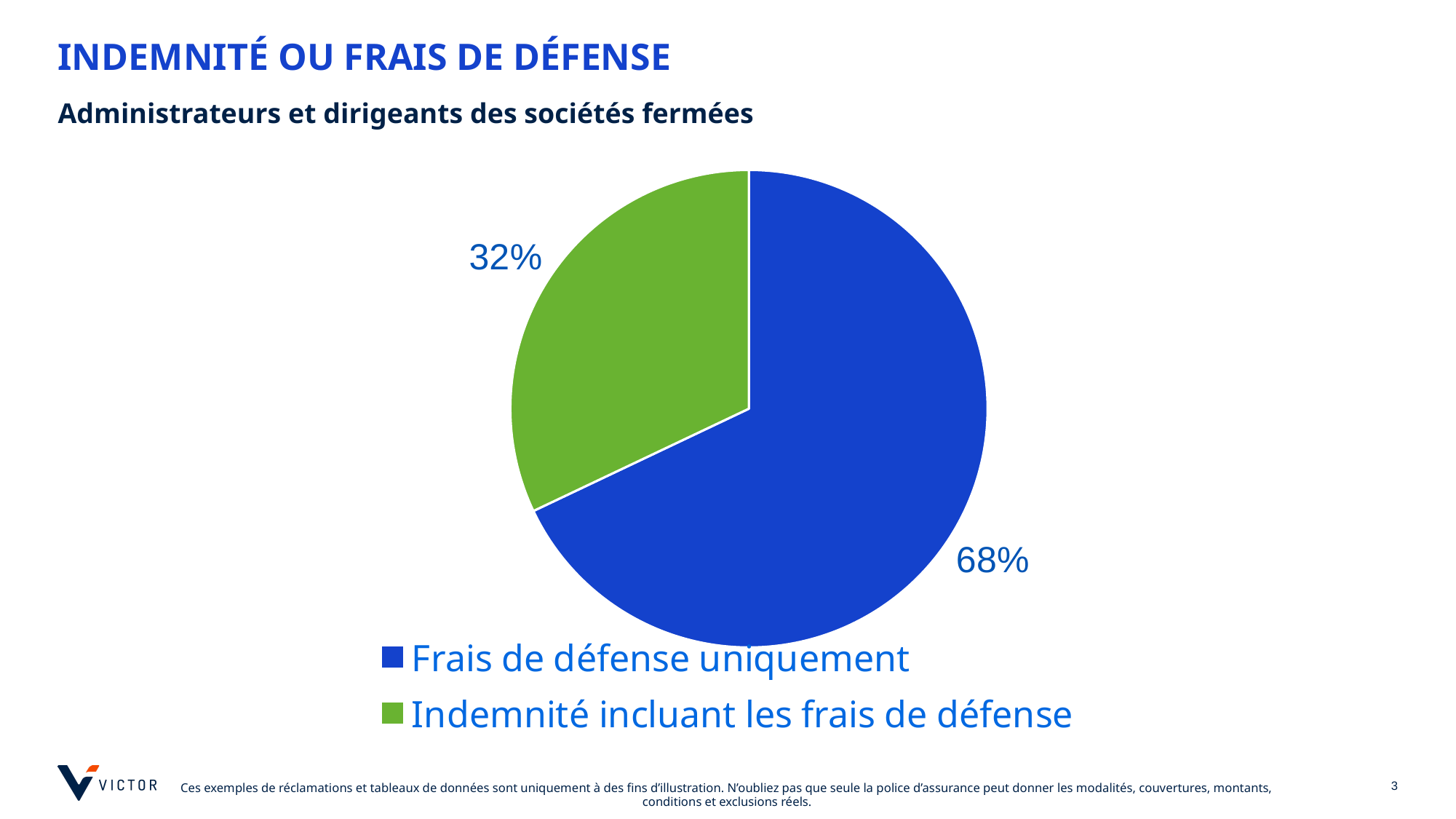
Is the share for "Indemnité incluant les frais de défense" greater or less than 50%? less How many slices does the pie chart have? 2 How many entries does the legend list? 2 What is the difference in percentage points between the "Frais de défense uniquement" slice and the "Indemnité incluant les frais de défense" slice? 36 What colour is the slice for "Indemnité incluant les frais de défense"? Green Which slice of the pie is the smallest? Indemnité incluant les frais de défense What colour is the slice for "Frais de défense uniquement"? Blue What share of the pie is labelled "Frais de défense uniquement"? 68% What share of the pie is labelled "Indemnité incluant les frais de défense"? 32% Which is larger: the share for "Frais de défense uniquement" or the share for "Indemnité incluant les frais de défense"? Frais de défense uniquement Which slice of the pie is the largest? Frais de défense uniquement What kind of chart is shown on the slide? Pie chart